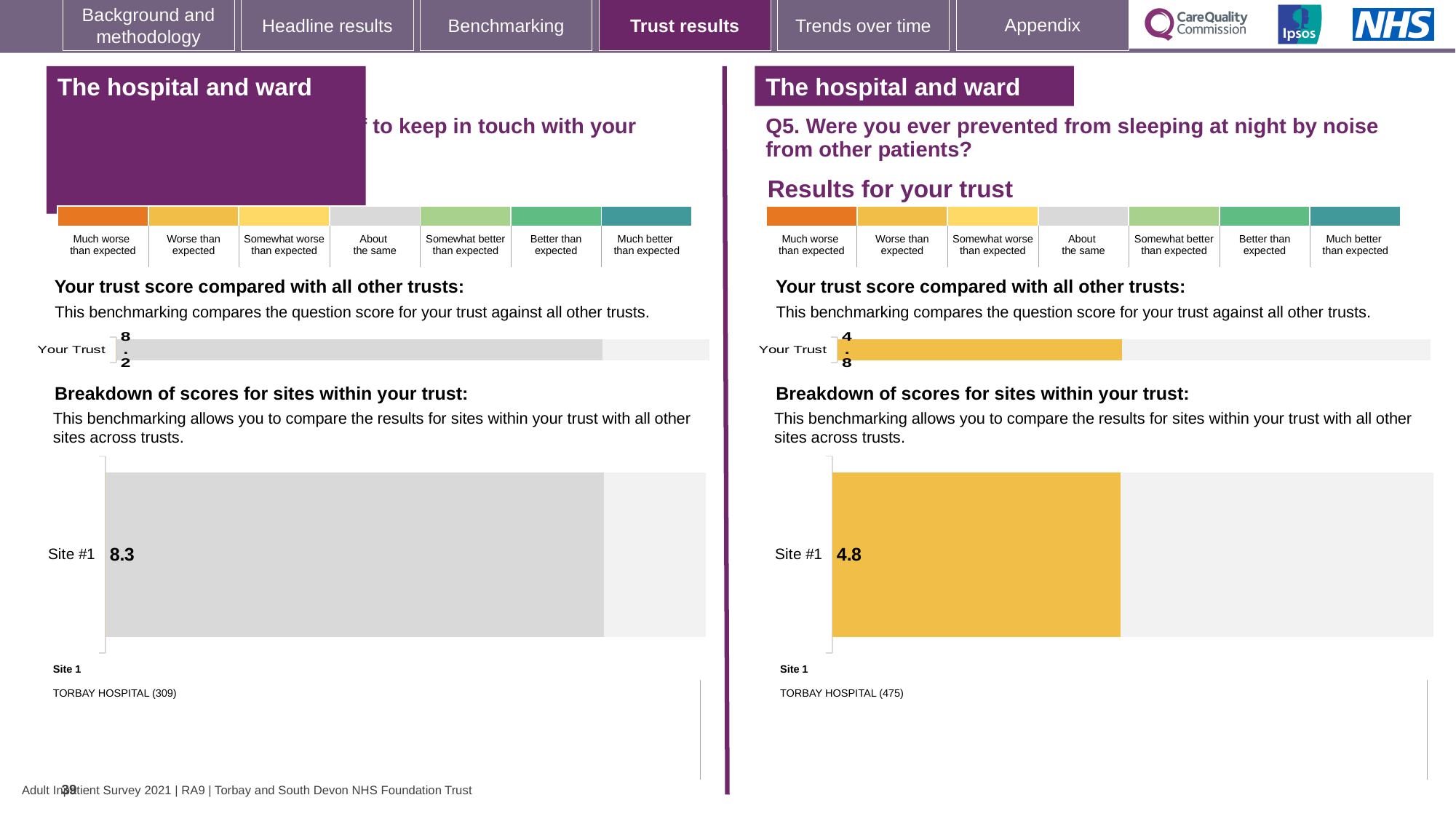
Which Site #1 score is larger: the one on the left-hand breakdown chart or the one on the right-hand (Q5) breakdown chart? The left-hand chart (8.3) What kind of chart is used to show the Site #1 score on the right-hand (Q5) breakdown chart? Bar chart On the left-hand side of the slide, what is the difference between the Site #1 score and the Your Trust score? 0.1 Which Your Trust score is larger: the one on the left-hand chart or the one on the right-hand (Q5) chart? The left-hand chart (8.2) On the right-hand (Q5) 'Your trust score compared with all other trusts' chart, what is the score shown for Your Trust? 4.8 According to the colour key, which benchmark category does the yellow Site #1 bar on the right-hand (Q5) breakdown chart represent? Worse than expected According to the colour key, which benchmark category does the grey Your Trust bar on the left-hand chart represent? About the same How many sites are shown in the right-hand (Q5) 'Breakdown of scores for sites within your trust' chart? 1 On the left-hand 'Breakdown of scores for sites within your trust' chart, what is the score for Site #1? 8.3 What is the difference between the Site #1 score on the left-hand breakdown chart and the Site #1 score on the right-hand (Q5) breakdown chart? 3.5 On the right-hand (Q5) 'Breakdown of scores for sites within your trust' chart, what is the score for Site #1? 4.8 On the left-hand 'Your trust score compared with all other trusts' chart, what is the score shown for Your Trust? 8.2